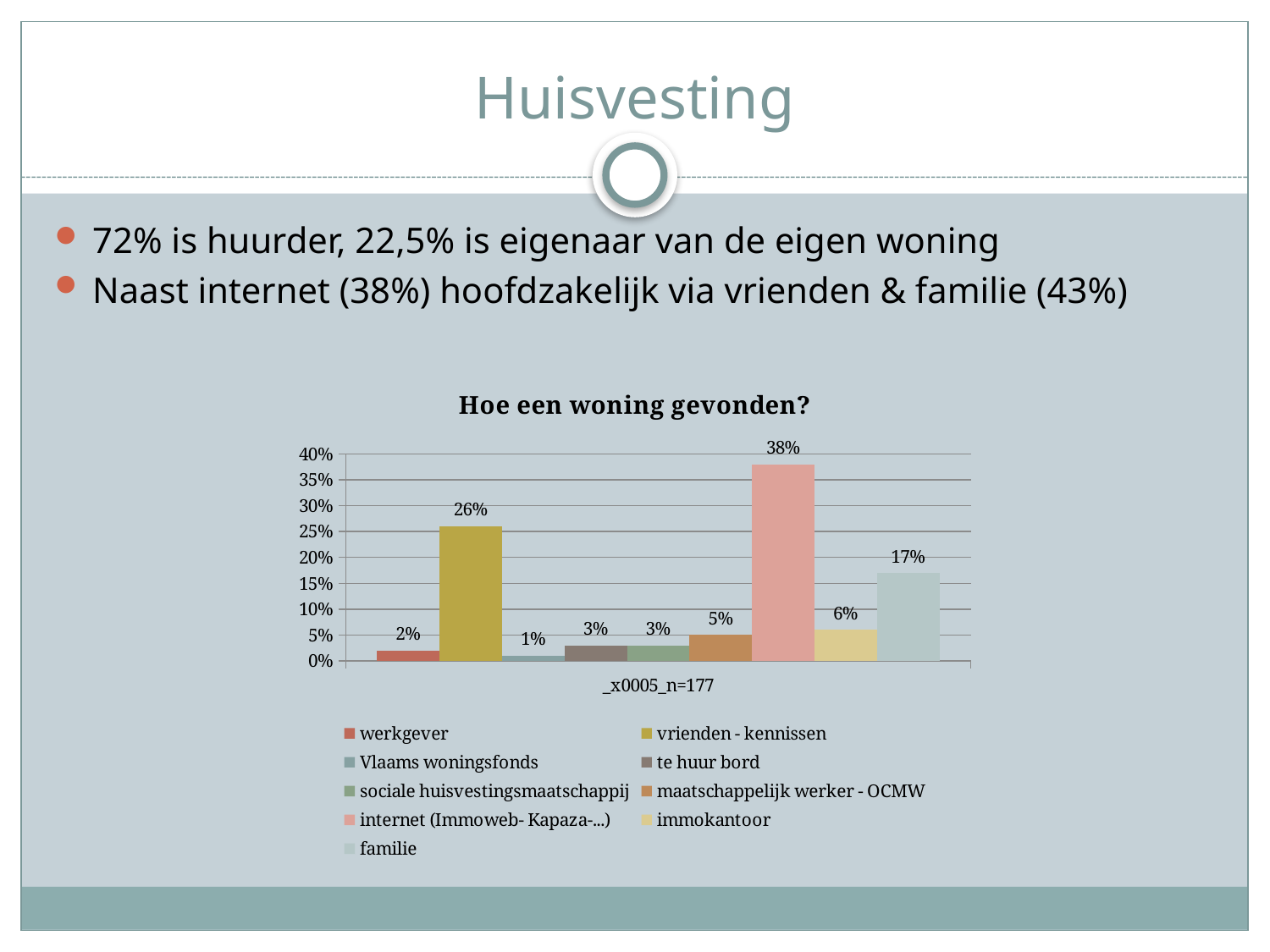
What is the value for vrienden - kennissen in the chart? 26% What is the difference between the values for internet (Immoweb- Kapaza-...) and vrienden - kennissen? 12% What is the difference between the values for familie and immokantoor? 11% Which is larger, the value for familie or the value for immokantoor? familie What is the title of the chart? Hoe een woning gevonden? What is the value for maatschappelijk werker - OCMW in the chart? 5% Which series has the lowest value in the chart? Vlaams woningsfonds How many series does the legend list? 9 What kind of chart is shown on the slide? bar chart Which series has the highest value in the chart? internet (Immoweb- Kapaza-...) What is the value for internet (Immoweb- Kapaza-...) in the chart "Hoe een woning gevonden?"? 38% What is the value for familie in the chart? 17%